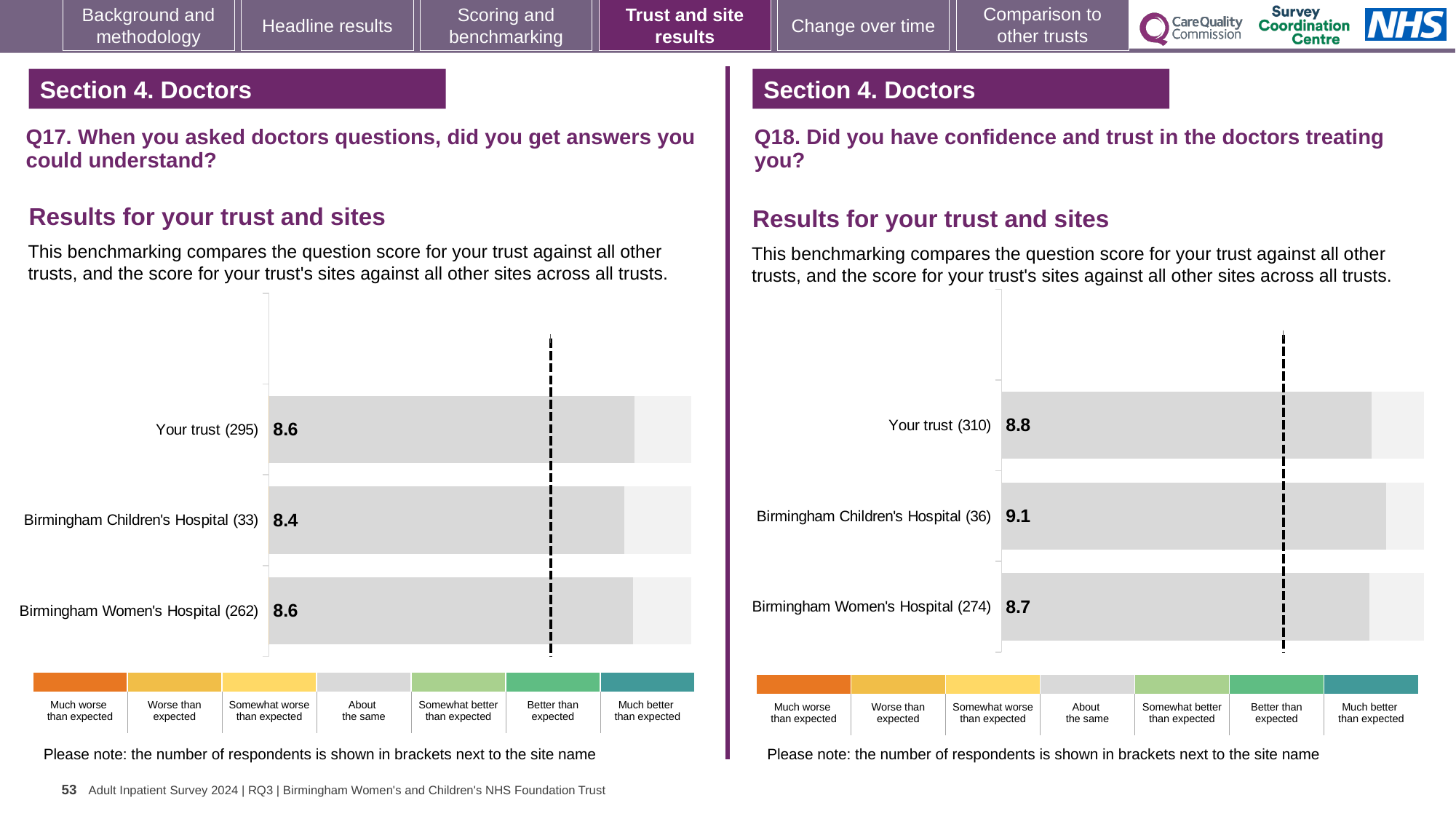
On the Q17 chart (left), which site has the lowest score? Birmingham Children's Hospital On the Q17 chart (left), what is the score for Birmingham Children's Hospital? 8.4 On the Q18 chart (right), what is the score for Birmingham Children's Hospital? 9.1 On the Q18 chart (right), what is the score for Birmingham Women's Hospital? 8.7 On the Q17 chart (left), what is the score for Your trust? 8.6 On the Q18 chart (right), which has the larger score: Your trust or Birmingham Women's Hospital? Your trust What type of chart is used on the Q18 chart (right)? Bar chart On the Q17 chart (left), how many respondents are shown in brackets for Birmingham Women's Hospital? 262 How many bars are plotted on the Q17 chart (left)? 3 On the Q18 chart (right), which site or trust has the highest score? Birmingham Children's Hospital On the Q17 chart (left), what is the difference between the scores for Your trust and Birmingham Children's Hospital? 0.2 On the Q18 chart (right), what is the difference between the scores for Birmingham Children's Hospital and Your trust? 0.3